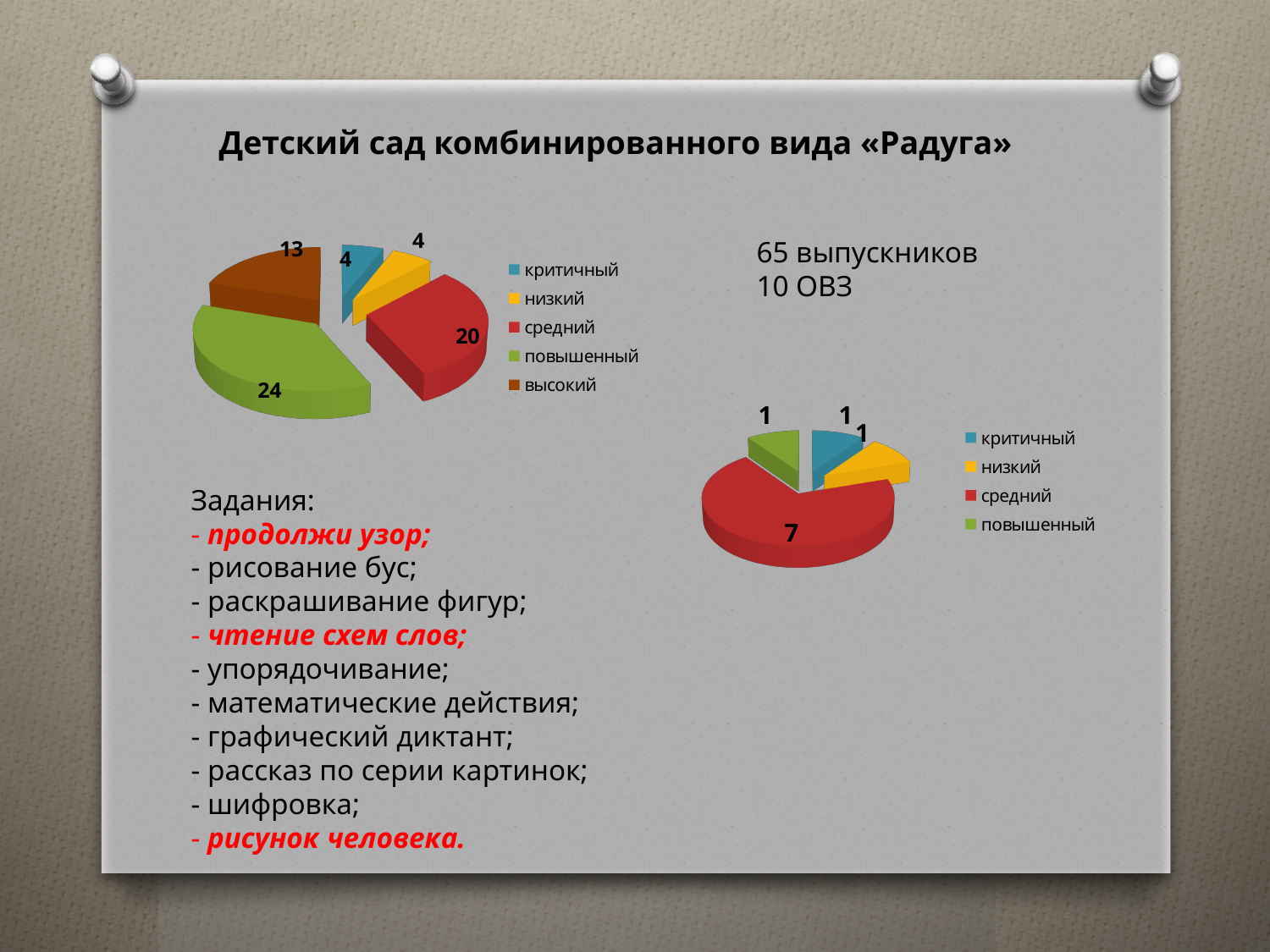
In the pie chart on the right, which category has the largest slice? средний What type of chart is shown on the right side of the slide? pie chart In the pie chart on the right, how many categories does the legend list? 4 In the pie chart on the right, what is the value for средний? 7 In the pie chart on the right, what share of the total does средний represent? 70% In the pie chart on the left, what share of the total does высокий represent? 20% In the pie chart on the left, what is the value for повышенный? 24 In the pie chart on the left, what is the value for высокий? 13 In the pie chart on the left, which category has the largest slice? повышенный In the pie chart on the left, which is larger: средний or высокий? средний In the pie chart on the left, what is the difference between the values for повышенный and средний? 4 In the pie chart on the left, how many categories does the legend list? 5